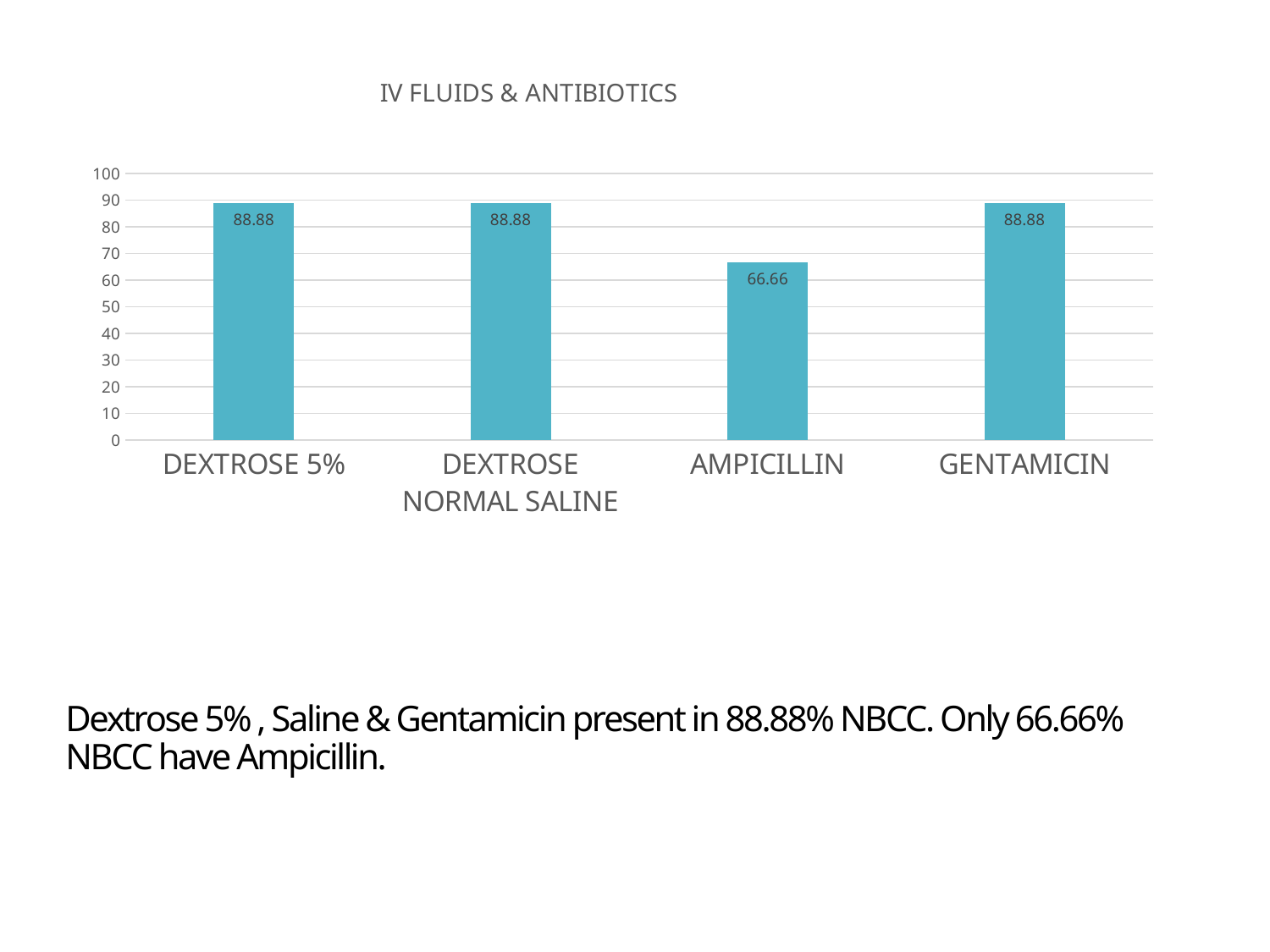
What is the value for AMPICILLIN? 66.66 What is the difference between the values for DEXTROSE 5% and AMPICILLIN? 22.22 How many categories have a value of 88.88? 3 Which category has the lowest value? AMPICILLIN Is the value for AMPICILLIN greater or less than 70? less What is the title of the chart? IV FLUIDS & ANTIBIOTICS Is the value for DEXTROSE 5% greater or less than 80? greater How many categories are shown on the x axis? 4 What is the value for GENTAMICIN? 88.88 What kind of chart is shown on the slide? bar chart Which is larger, the value for GENTAMICIN or the value for AMPICILLIN? GENTAMICIN What is the value for DEXTROSE NORMAL SALINE? 88.88